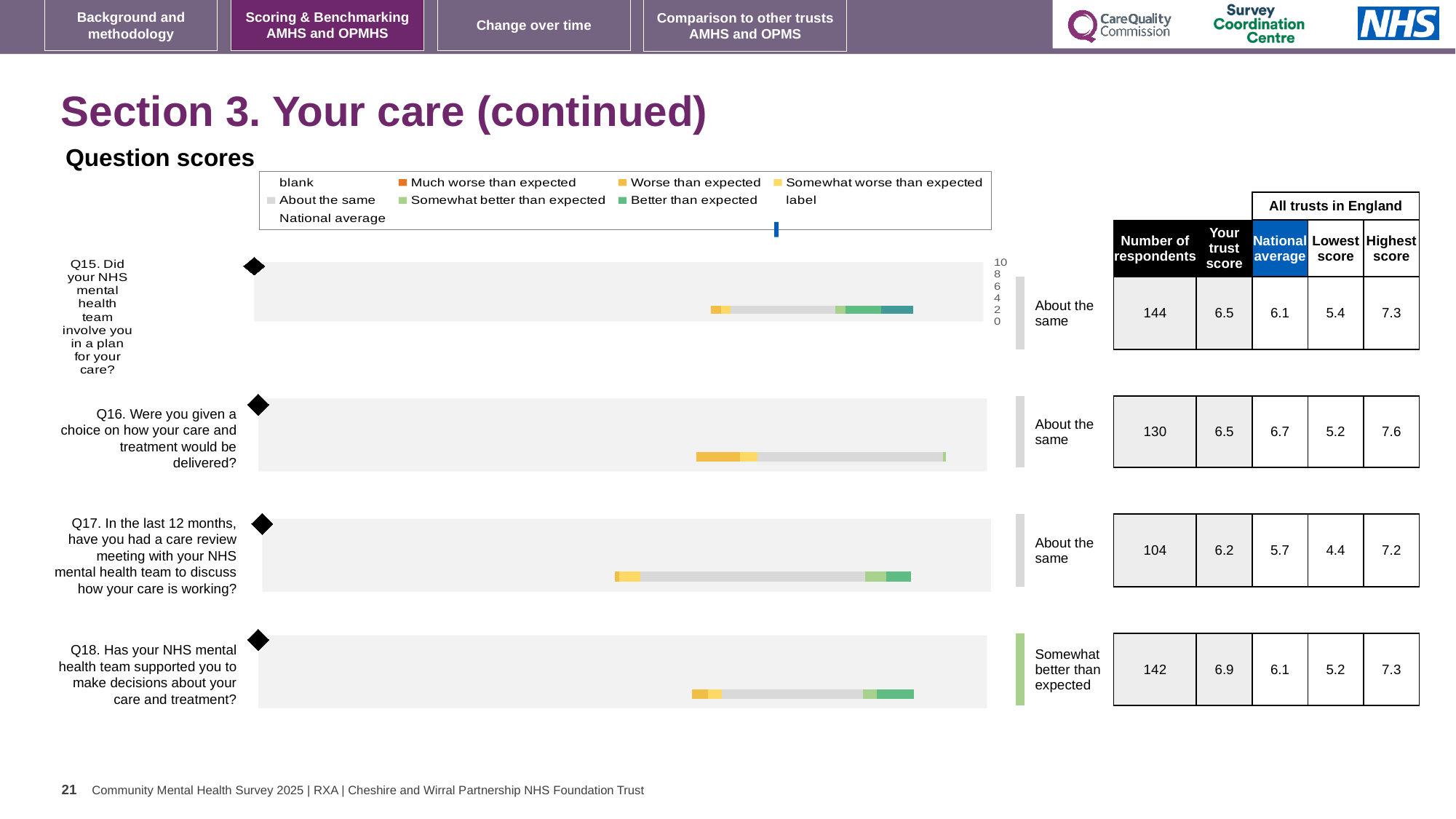
What kind of chart is used to show the question scores? Bar chart What is the national average score for Q17 (care review meeting in the last 12 months)? 5.7 What is the 'Your trust score' value for Q18 (Has your NHS mental health team supported you to make decisions about your care and treatment?)? 6.9 What benchmark label is shown for Q18? Somewhat better than expected For Q16, which is larger: the trust score or the national average? National average Which question has the highest 'Your trust score'? Q18 What is the difference between the trust score and the national average for Q17? 0.5 Which question has the highest 'Highest score' among all trusts in England? Q16 How many questions are plotted on this slide? 4 What is the lowest score among all trusts in England for Q17? 4.4 Which question has the lowest number of respondents? Q17 How many respondents answered Q15 (Did your NHS mental health team involve you in a plan for your care?)? 144